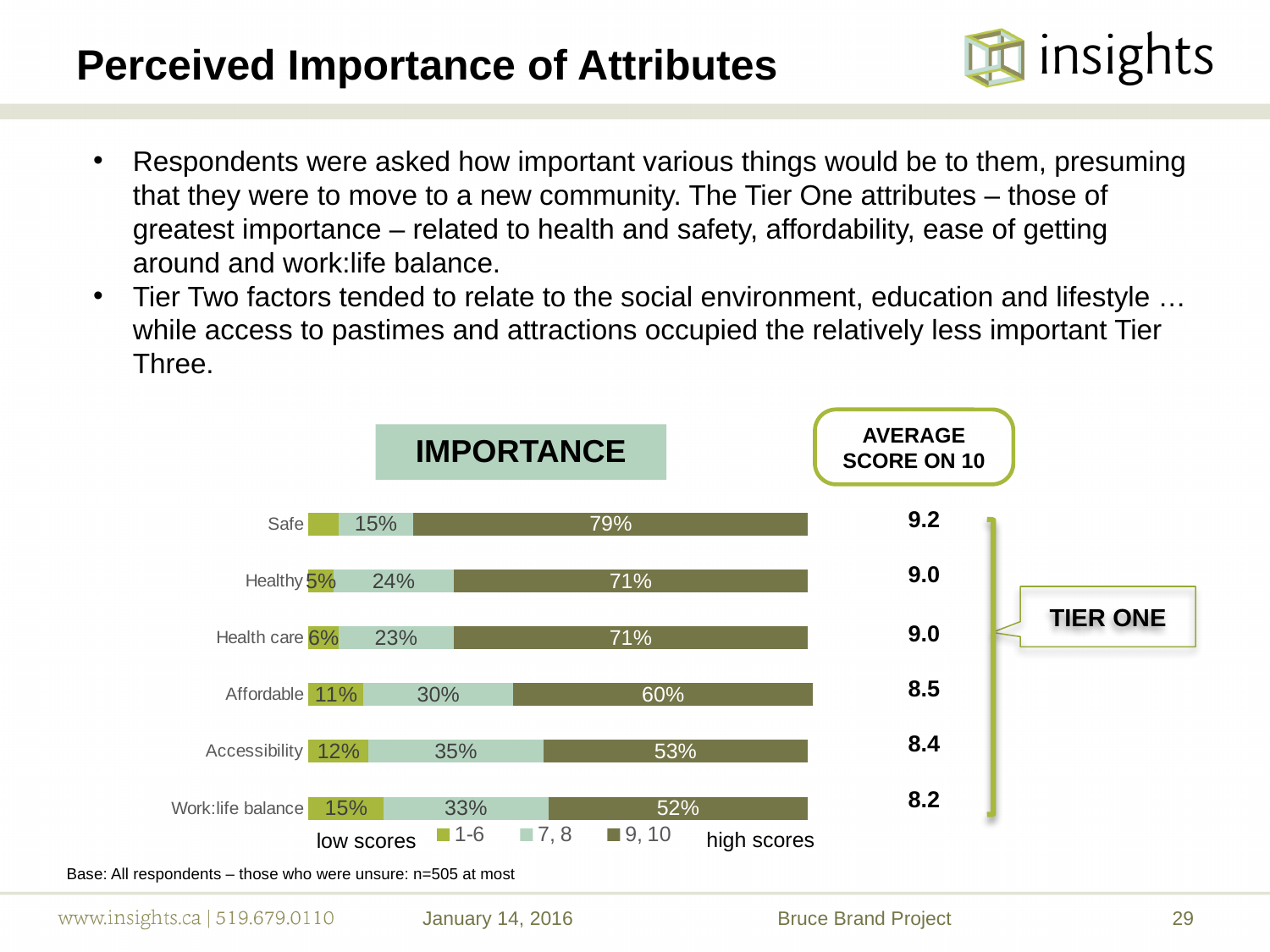
What percentage of respondents gave "Work:life balance" a score of 1-6? 15% What percentage of respondents gave "Safe" a score of 9 or 10? 79% How many series does the legend list? 3 What is the average score on 10 shown for "Affordable"? 8.5 Which attribute has the lowest share of 9, 10 scores? Work:life balance What label is shown in the callout box to the right of the average scores? TIER ONE What kind of chart is used to show the importance scores? Stacked bar chart How many attributes are shown in the chart? 6 What percentage of respondents gave "Affordable" a score of 7 or 8? 30% Which has a larger 7, 8 share: "Accessibility" or "Healthy"? Accessibility Which attribute has the highest share of 9, 10 scores? Safe What is the difference between the 9, 10 share for "Safe" and for "Accessibility"? 26%